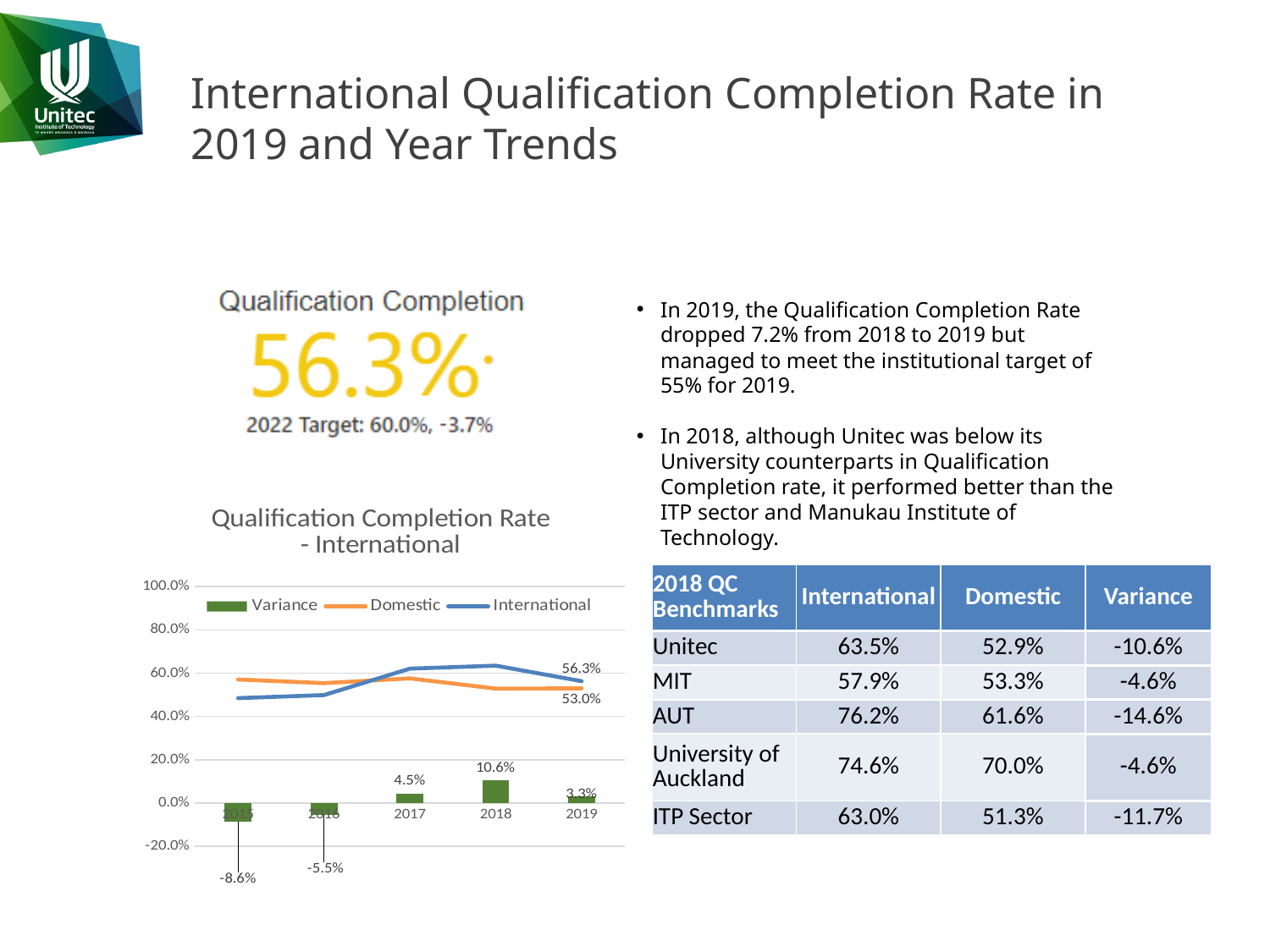
What is the International value for 2019 in the chart? 56.3% In 2019, which is larger in the chart: the International value or the Domestic value? International Is the International value for 2015 greater or less than 60.0%? less What is the Variance value for 2016 in the chart? -5.5% Which year has the lowest Variance value in the chart? 2015 What is the difference between the Variance values for 2018 and 2017? 6.1% Which year has the highest Variance value in the chart? 2018 How many years are shown on the x axis of the chart? 5 What is the Variance value for 2015 in the chart? -8.6% What is the Variance value for 2018 in the Qualification Completion Rate - International chart? 10.6% What is the Domestic value for 2019 in the chart? 53.0% How many series does the chart's legend list? 3